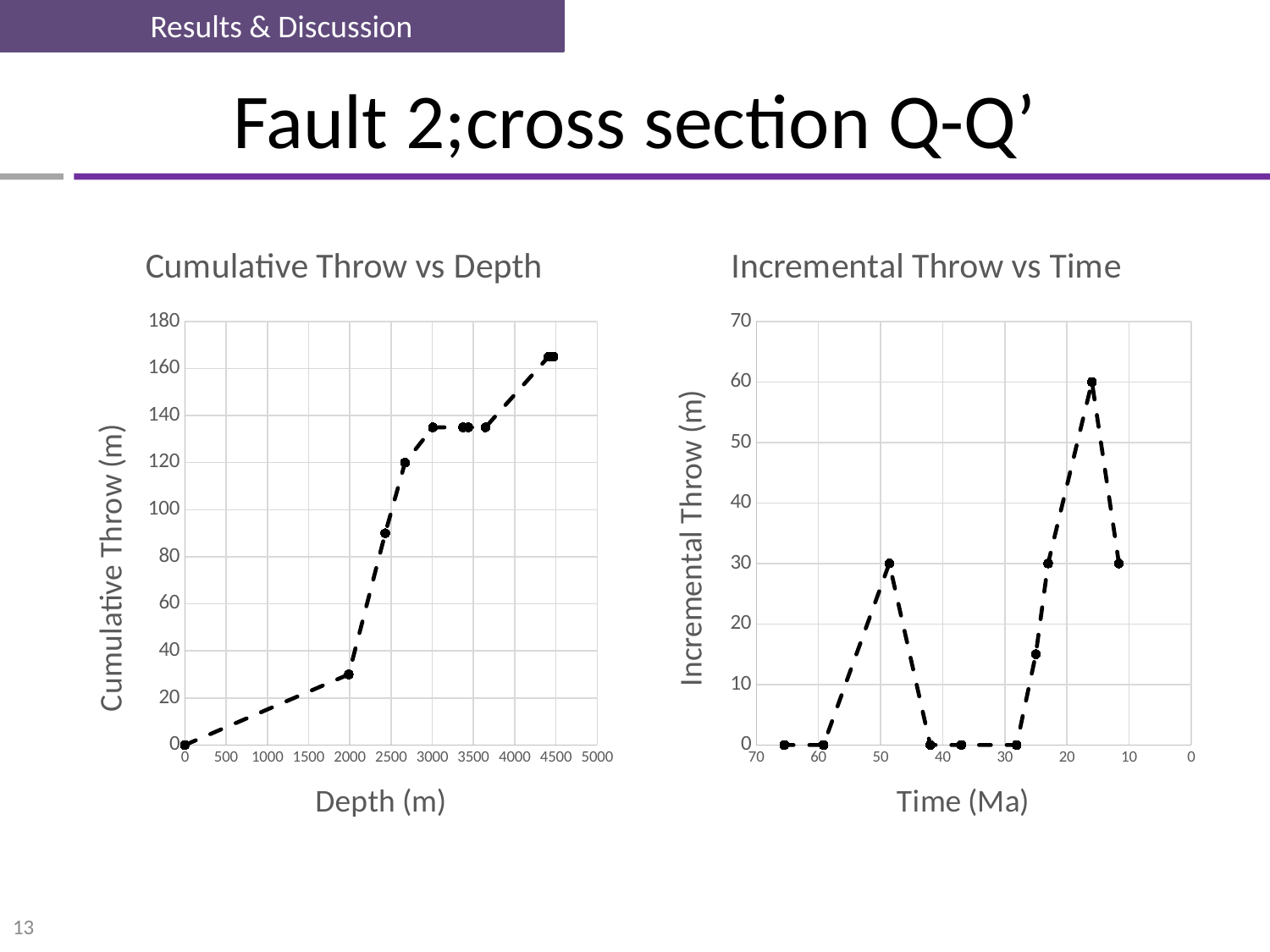
In the 'Incremental Throw vs Time' chart, is the peak near 50 Ma greater or less than 40? less What kind of chart is the 'Cumulative Throw vs Depth' chart? line chart What kind of chart is the 'Incremental Throw vs Time' chart? line chart How many data points are plotted in the 'Incremental Throw vs Time' chart? 10 In the 'Cumulative Throw vs Depth' chart, does cumulative throw generally rise or fall as depth increases? rise In the 'Cumulative Throw vs Depth' chart, is the cumulative throw at the deepest plotted point greater or less than 160? greater In the 'Incremental Throw vs Time' chart, which peak is larger: the one near 50 Ma or the one near 16 Ma? the one near 16 Ma In the 'Cumulative Throw vs Depth' chart, is the cumulative throw at a depth of 2000 m greater or less than 40? less In the 'Cumulative Throw vs Depth' chart, what is the x-axis title? Depth (m) In the 'Incremental Throw vs Time' chart, what is the highest incremental throw value reached? 60 In the 'Incremental Throw vs Time' chart, what is the y-axis title? Incremental Throw (m) In the 'Cumulative Throw vs Depth' chart, what is the cumulative throw at a depth of 0 m? 0